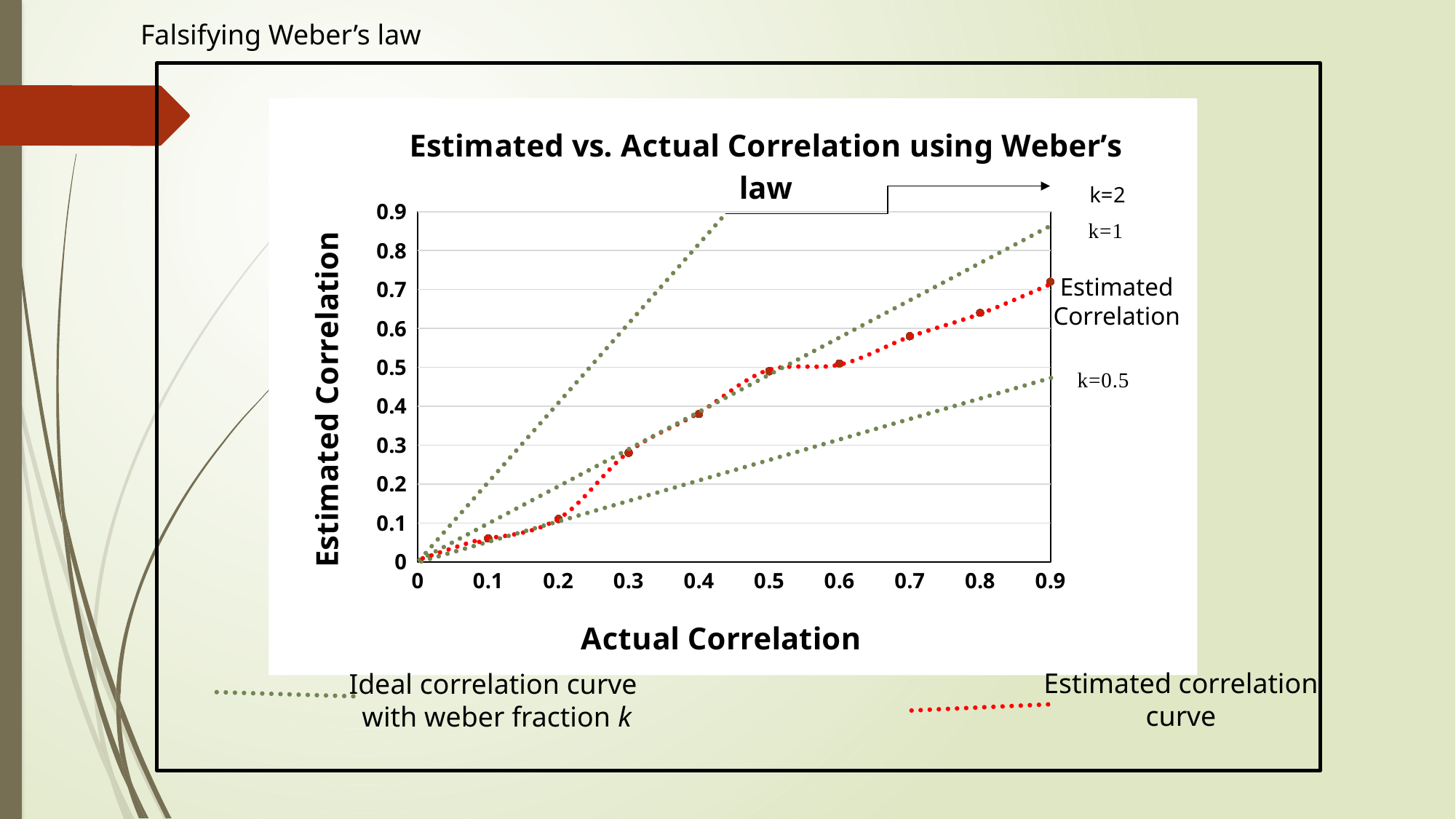
Is the value of the k=2 curve at an Actual Correlation of 0.4 greater or less than 0.7? greater What is the title of the chart? Estimated vs. Actual Correlation using Weber's law Is the value of the k=0.5 curve at an Actual Correlation of 0.8 greater or less than 0.5? less Is the Estimated Correlation value at an Actual Correlation of 0.9 greater or less than 0.8? less Which curve has the highest value at an Actual Correlation of 0.4? k=2 What is the label of the x axis? Actual Correlation What kind of chart is shown on the slide? line chart How many ideal correlation curves with different weber fractions k are labelled on the chart? 3 At an Actual Correlation of 0.9, which is higher: the k=1 curve or the Estimated Correlation curve? k=1 curve How many tick labels are shown on the x axis? 10 Does the Estimated Correlation curve rise or fall as Actual Correlation increases? rise